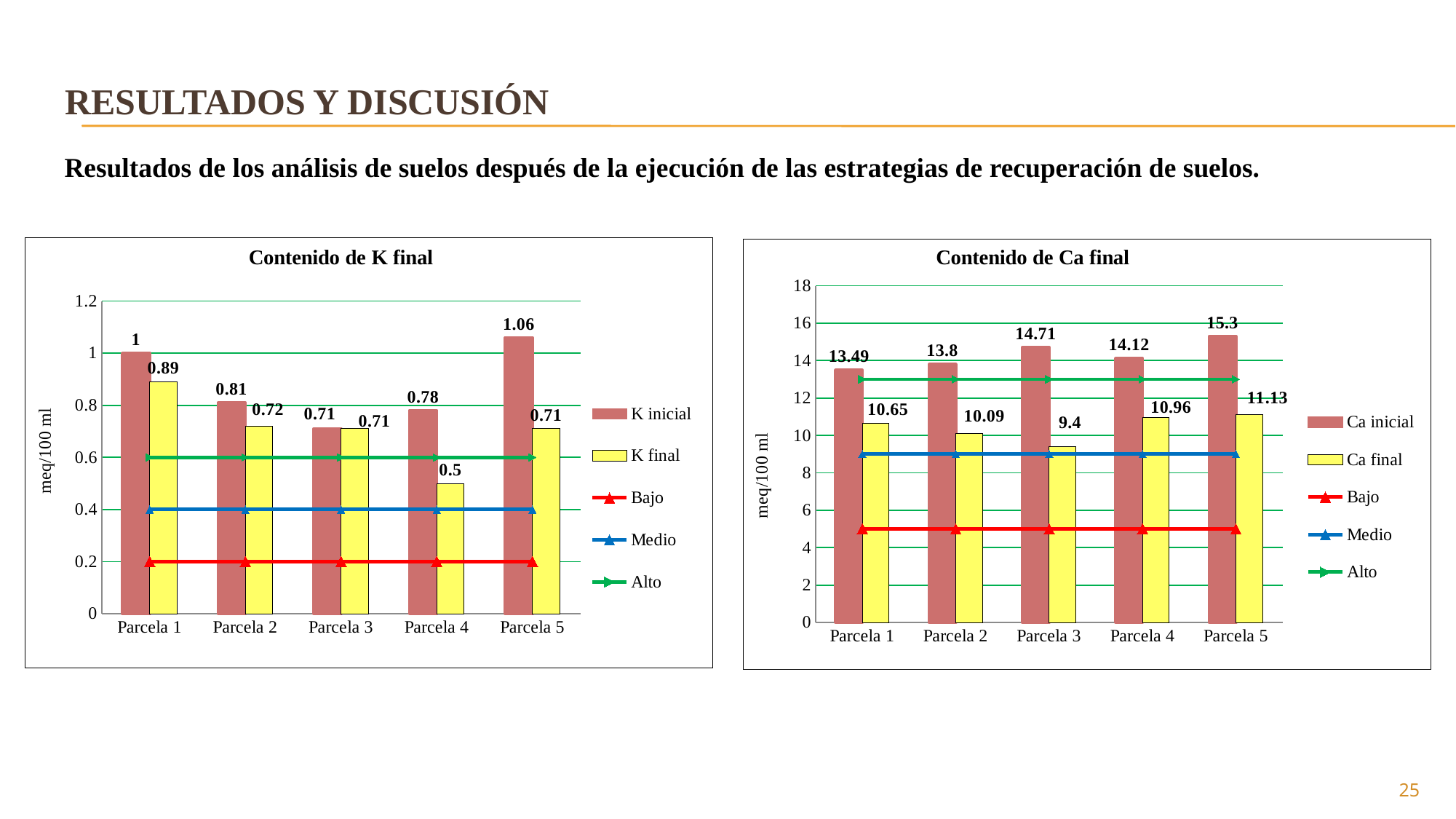
In the 'Contenido de K final' chart, which parcela has the lowest K final value? Parcela 4 In the 'Contenido de Ca final' chart, what is the Ca inicial value for Parcela 3? 14.71 In the 'Contenido de K final' chart, what is the K inicial value for Parcela 5? 1.06 In the 'Contenido de Ca final' chart, which parcela has the lowest Ca final value? Parcela 3 In the 'Contenido de Ca final' chart, how many parcelas are shown on the x axis? 5 What is the y-axis label of the 'Contenido de Ca final' chart? meq/100 ml In the 'Contenido de K final' chart, how many series does the legend list? 5 In the 'Contenido de Ca final' chart, what is the Ca final value for Parcela 2? 10.09 In the 'Contenido de K final' chart, what is the difference between K inicial and K final for Parcela 1? 0.11 In the 'Contenido de Ca final' chart, which parcela has the highest Ca inicial value? Parcela 5 In the 'Contenido de Ca final' chart, which is larger: the Ca final value for Parcela 4 or for Parcela 1? Parcela 4 In the 'Contenido de K final' chart, what is the K final value for Parcela 4? 0.5